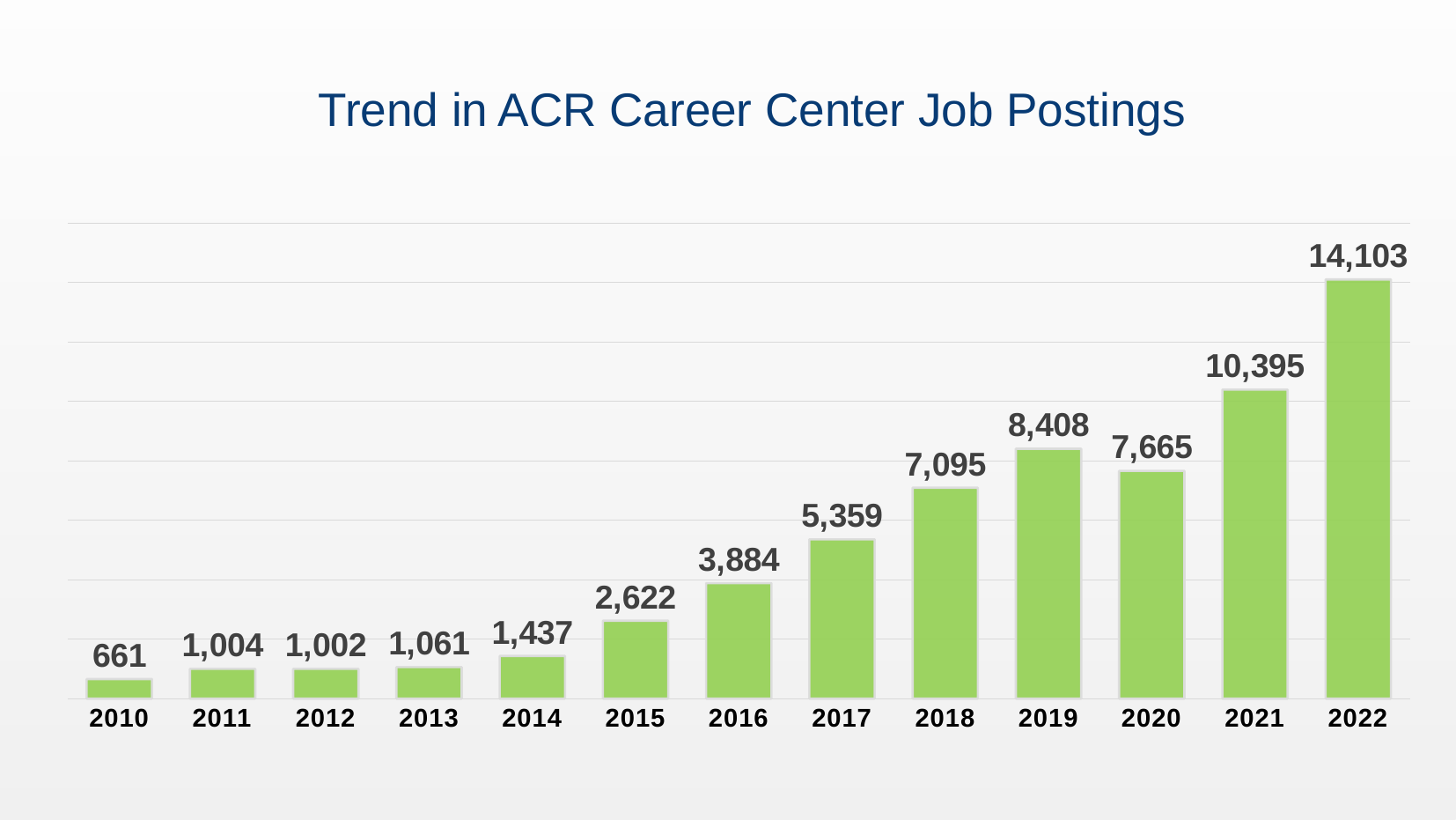
Which year has a larger value, 2019 or 2020? 2019 What kind of chart is shown on the slide? Bar chart What is the value for 2010? 661 What value is shown for 2020? 7,665 Which year has the lowest number of job postings? 2010 What is the number of job postings shown for 2016? 3,884 What is the difference between the values for 2022 and 2021? 3,708 Which year has the highest number of job postings? 2022 How many years are shown on the x axis? 13 Which year has a larger value, 2014 or 2015? 2015 What is the difference between the values for 2019 and 2020? 743 What is the title of the chart? Trend in ACR Career Center Job Postings